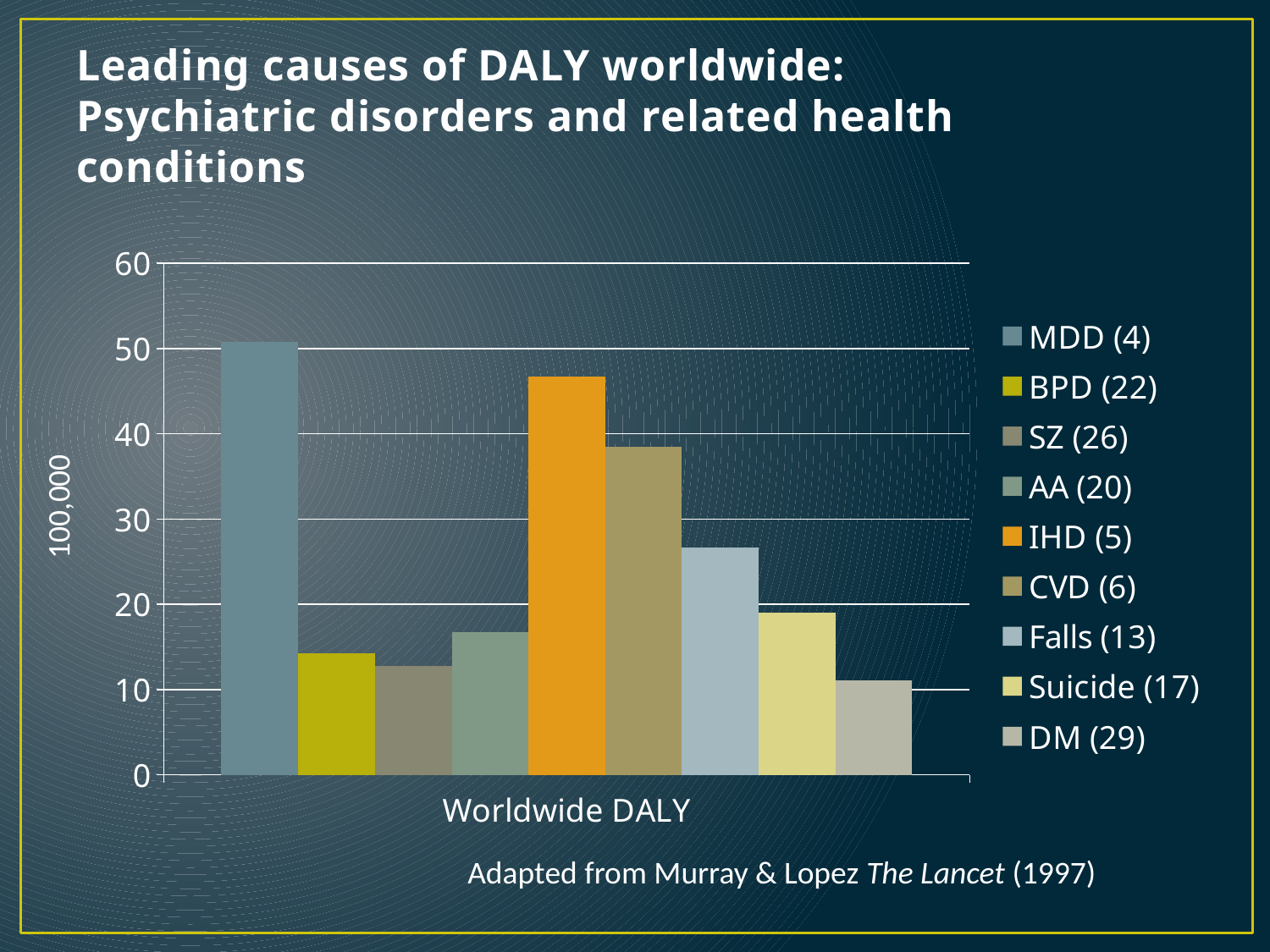
Which series has the lowest value for Worldwide DALY? DM (29) Is the value for CVD (6) greater or less than 30? greater Which is larger, the value for IHD (5) or the value for CVD (6)? IHD (5) What is the category label shown on the horizontal axis? Worldwide DALY What is the label on the vertical axis? 100,000 Which is larger, the value for Falls (13) or the value for Suicide (17)? Falls (13) What kind of chart is shown on the slide? bar chart Is the value for SZ (26) greater or less than 20? less Is the value for MDD (4) greater or less than 40? greater How many series does the legend list? 9 Which series has the highest value for Worldwide DALY? MDD (4)